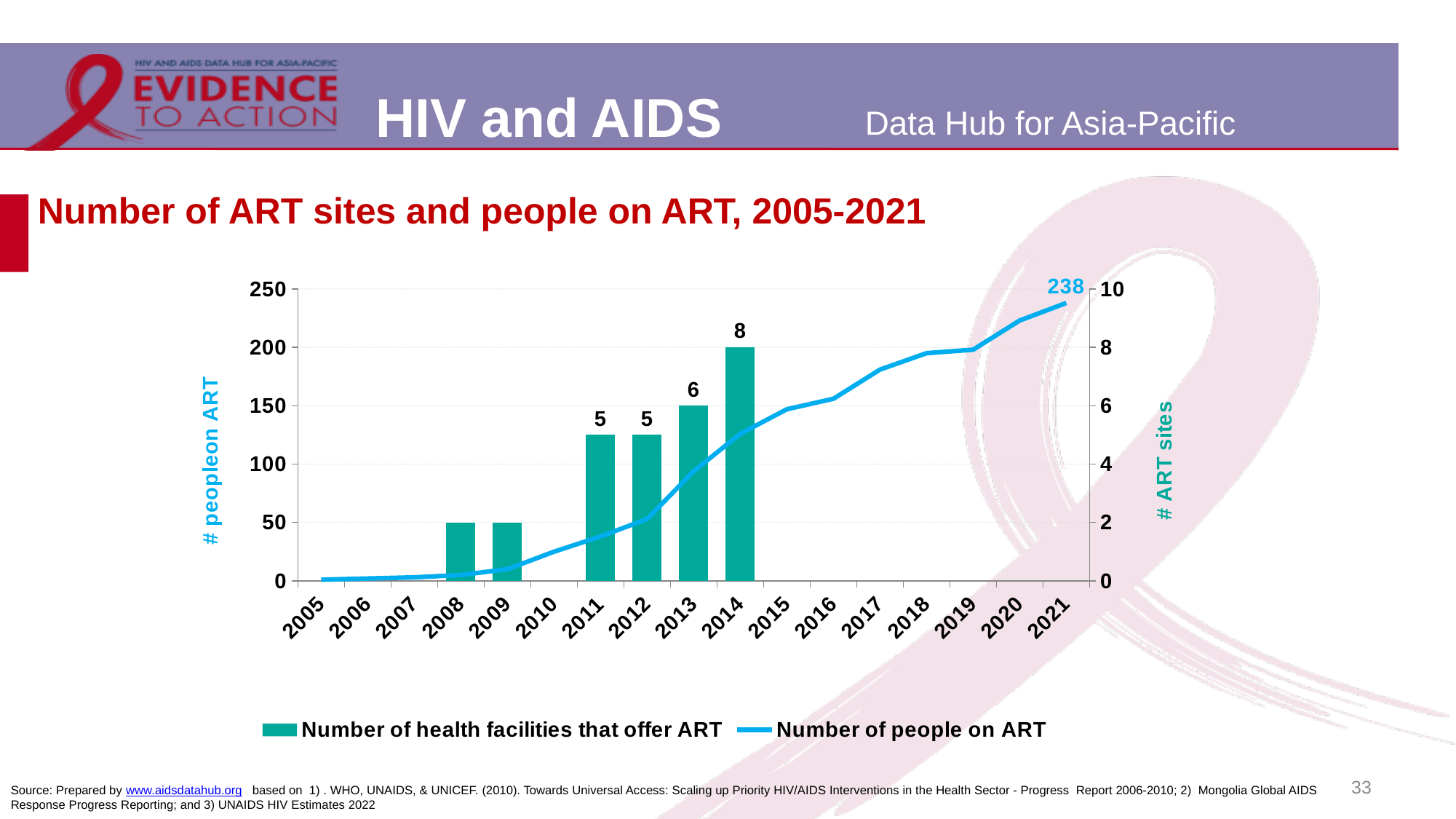
Is the number of people on ART in 2017 greater or less than 150? greater In which year is the number of health facilities that offer ART highest? 2014 How many years are shown on the x axis? 17 Does the number of people on ART rise or fall from 2005 to 2021? rise What is the number of people on ART in 2021? 238 Which year has more health facilities that offer ART, 2012 or 2013? 2013 Is the number of people on ART in 2010 greater or less than 50? less How many series does the legend list? 2 How many health facilities offered ART in 2014? 8 What is the difference between the number of health facilities that offer ART in 2014 and in 2013? 2 What is the number of health facilities that offer ART in 2011? 5 What is the number of health facilities that offer ART in 2013? 6